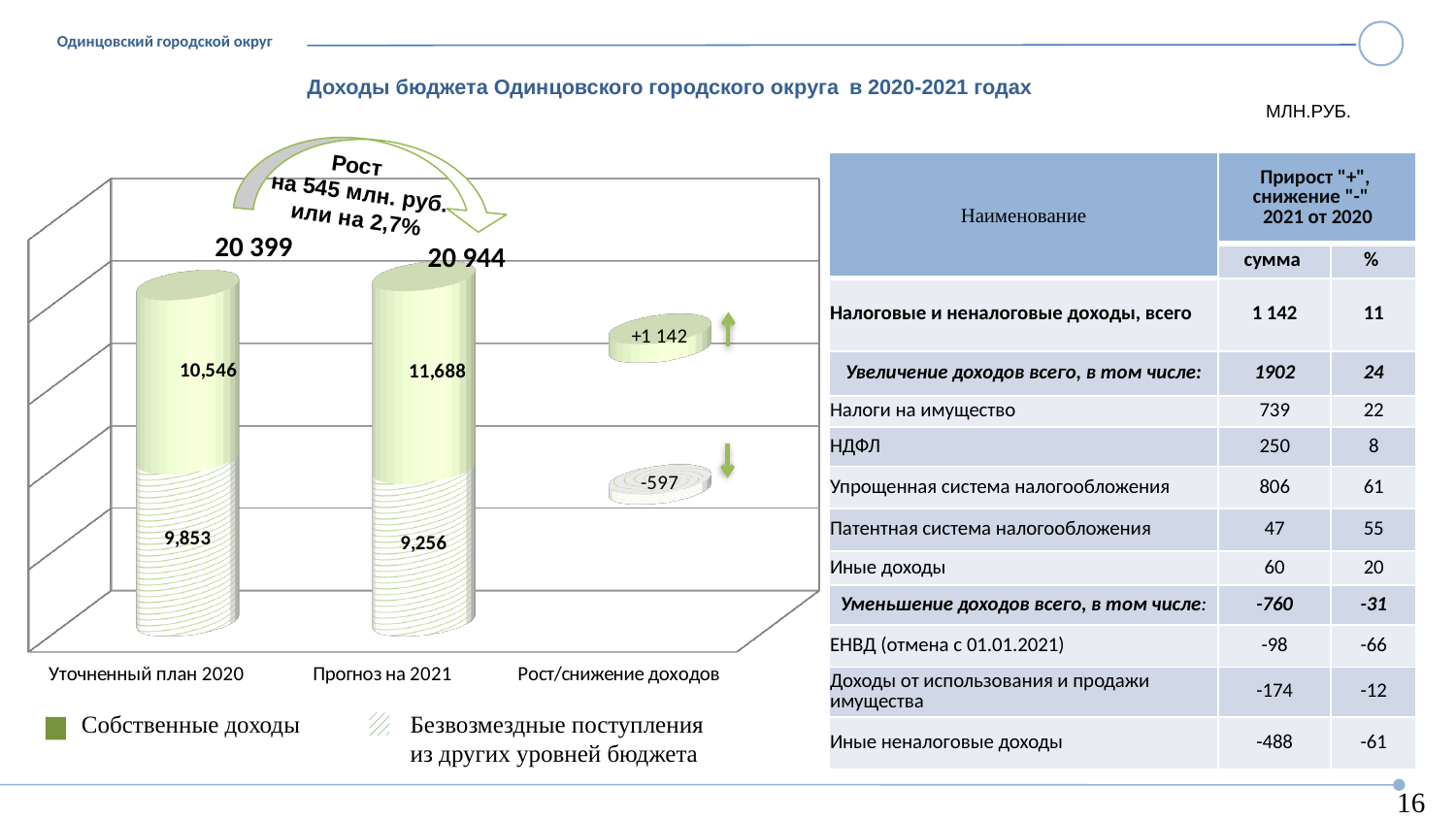
What is the difference between Собственные доходы in Прогноз на 2021 and in Уточненный план 2020? 1,142 What growth in total revenue does the arrow annotation on the chart state? на 545 млн. руб. или на 2,7% What is the total shown above the stacked bar for Уточненный план 2020? 20 399 What is the total shown above the stacked bar for Прогноз на 2021? 20 944 What is the difference between Безвозмездные поступления in Уточненный план 2020 and in Прогноз на 2021? 597 What type of chart is shown on the slide? Stacked bar chart Which is larger: Собственные доходы in Уточненный план 2020 or in Прогноз на 2021? Прогноз на 2021 What is the value of Собственные доходы for Уточненный план 2020? 10,546 How many series does the chart legend list? 2 What is the value of Безвозмездные поступления из других уровней бюджета for Уточненный план 2020? 9,853 What is the value of Собственные доходы for Прогноз на 2021? 11,688 What is the value of Безвозмездные поступления из других уровней бюджета for Прогноз на 2021? 9,256